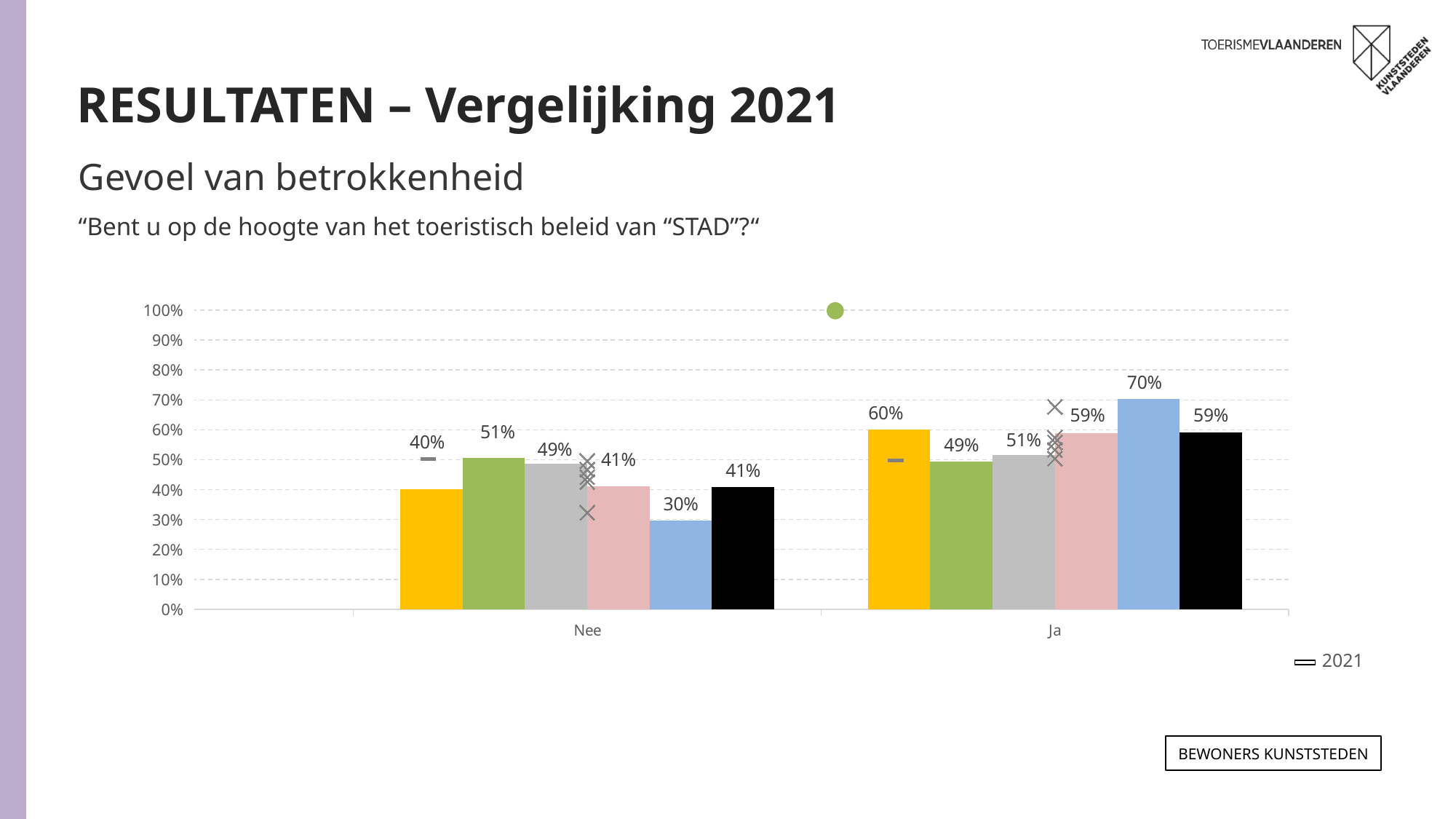
What entry does the legend of the chart list? 2021 Which bar has the lowest value in the category "Nee"? the blue bar (30%) Which is larger: the yellow bar for "Ja" or the yellow bar for "Nee"? the yellow bar for "Ja" (60%) What is the value of the green bar for the category "Nee"? 51% What type of chart is shown on the slide? bar chart What is the value of the black bar for the category "Ja"? 59% Which bar has the highest value in the category "Ja"? the blue bar (70%) What is the value of the yellow bar for the category "Nee"? 40% What is the difference between the blue bar for "Ja" and the blue bar for "Nee"? 40% What is the value of the blue bar for the category "Ja"? 70% Is the value of the pink bar for "Ja" greater or less than 50%? greater How many categories are shown on the x axis of the chart? 2